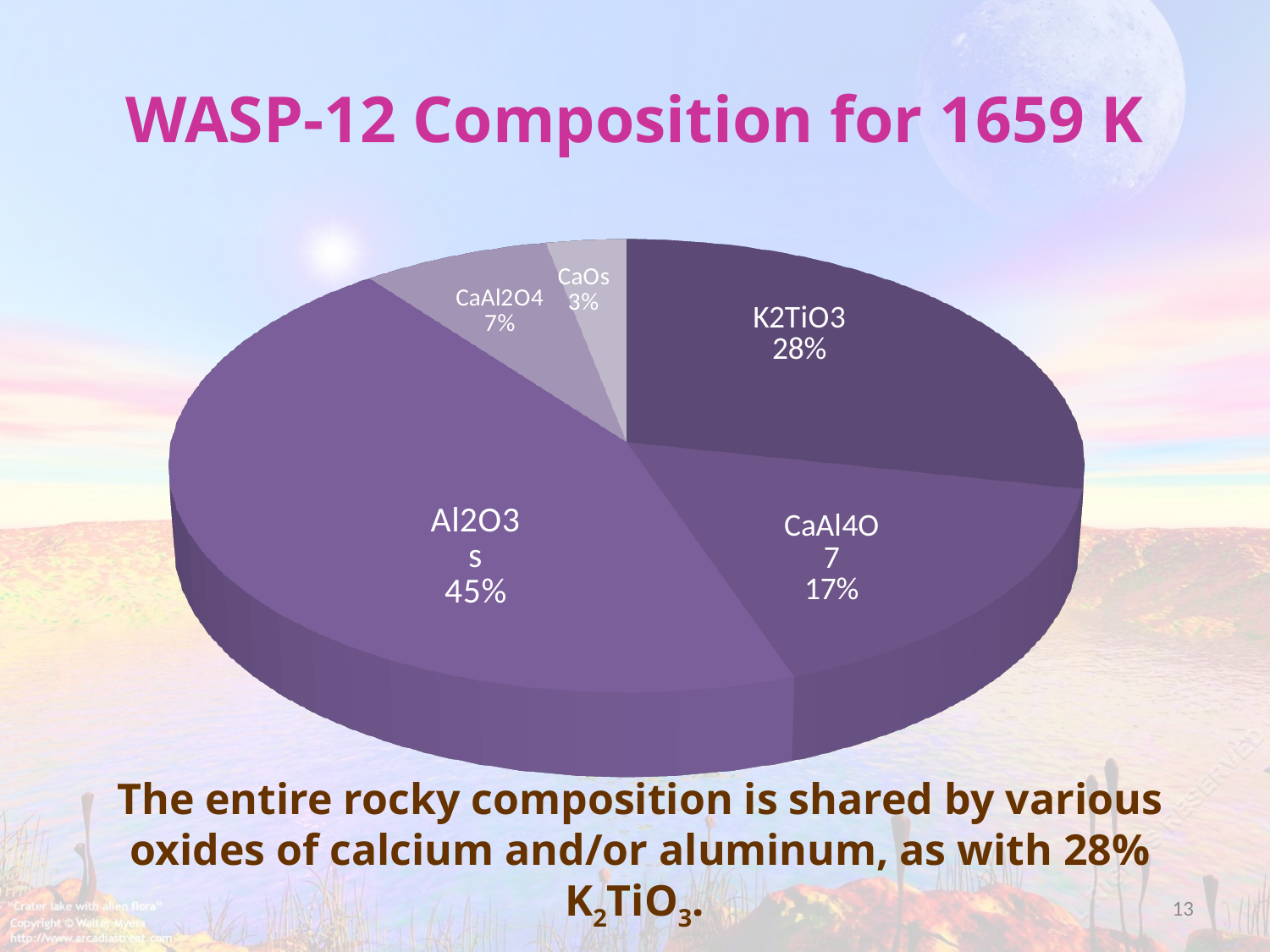
What share of the pie does CaAl4O7 have? 17% What kind of chart is shown on the slide? pie chart What share of the pie does CaOs have? 3% Which slice of the pie is the smallest? CaOs What is the title of the chart on the slide? WASP-12 Composition for 1659 K What share of the pie does CaAl2O4 have? 7% What is the difference in percentage points between the Al2O3s slice and the K2TiO3 slice? 17 Which is larger, the CaAl4O7 slice or the CaAl2O4 slice? CaAl4O7 Which slice of the pie is the largest? Al2O3s How many slices does the pie chart have? 5